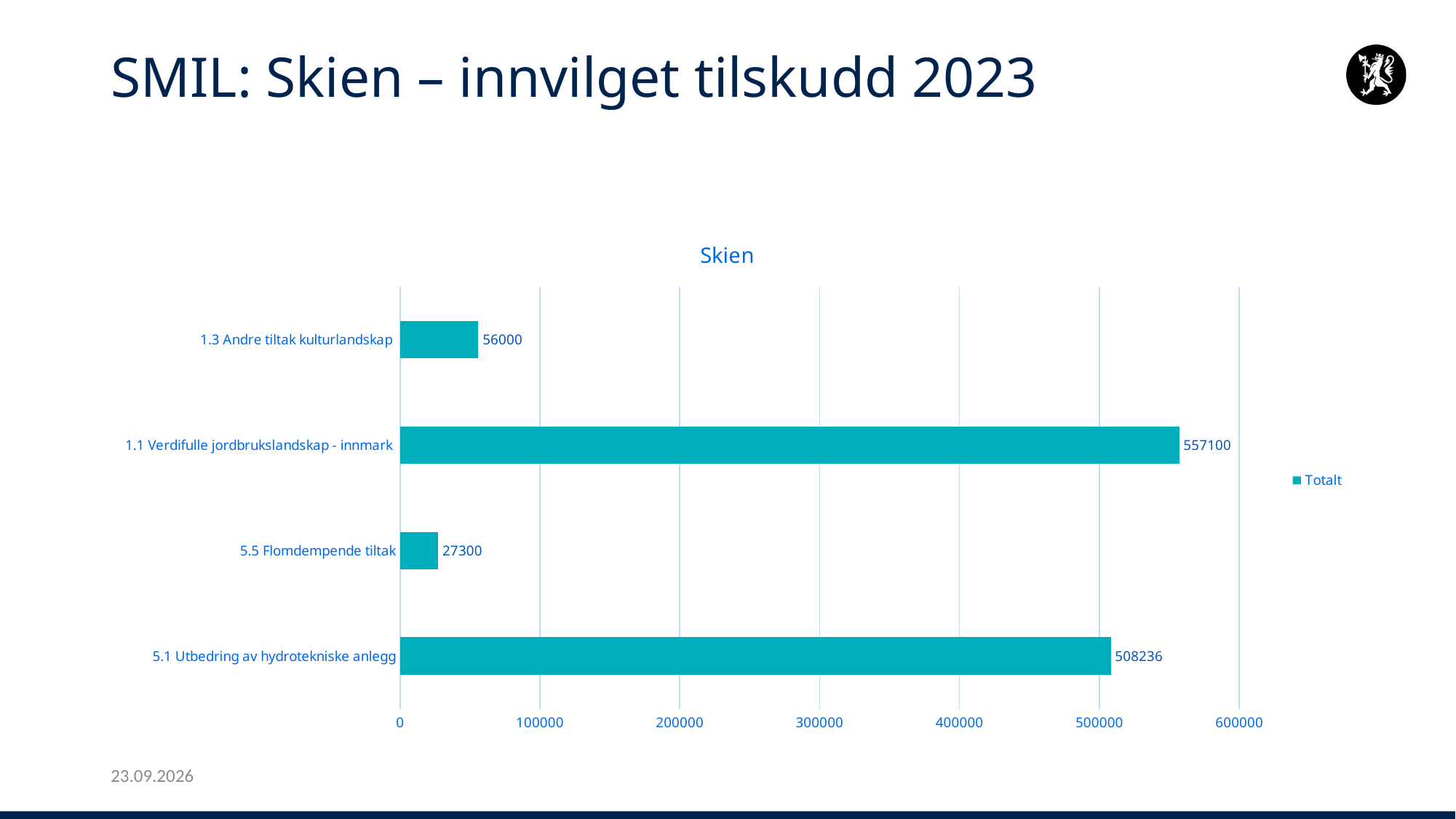
What is the value for 1.3 Andre tiltak kulturlandskap? 56000 Is the value for 5.1 Utbedring av hydrotekniske anlegg greater or less than 500000? greater Which category has the highest value? 1.1 Verdifulle jordbrukslandskap - innmark What kind of chart is shown on the slide? bar chart What is the value for 1.1 Verdifulle jordbrukslandskap - innmark? 557100 How many categories are shown in the chart? 4 Which category has the lowest value? 5.5 Flomdempende tiltak What is the value for 5.1 Utbedring av hydrotekniske anlegg? 508236 What is the title of the chart? Skien What is the difference between the values for 1.1 Verdifulle jordbrukslandskap - innmark and 5.1 Utbedring av hydrotekniske anlegg? 48864 What is the value for 5.5 Flomdempende tiltak? 27300 Which is larger, the value for 1.3 Andre tiltak kulturlandskap or the value for 5.5 Flomdempende tiltak? 1.3 Andre tiltak kulturlandskap